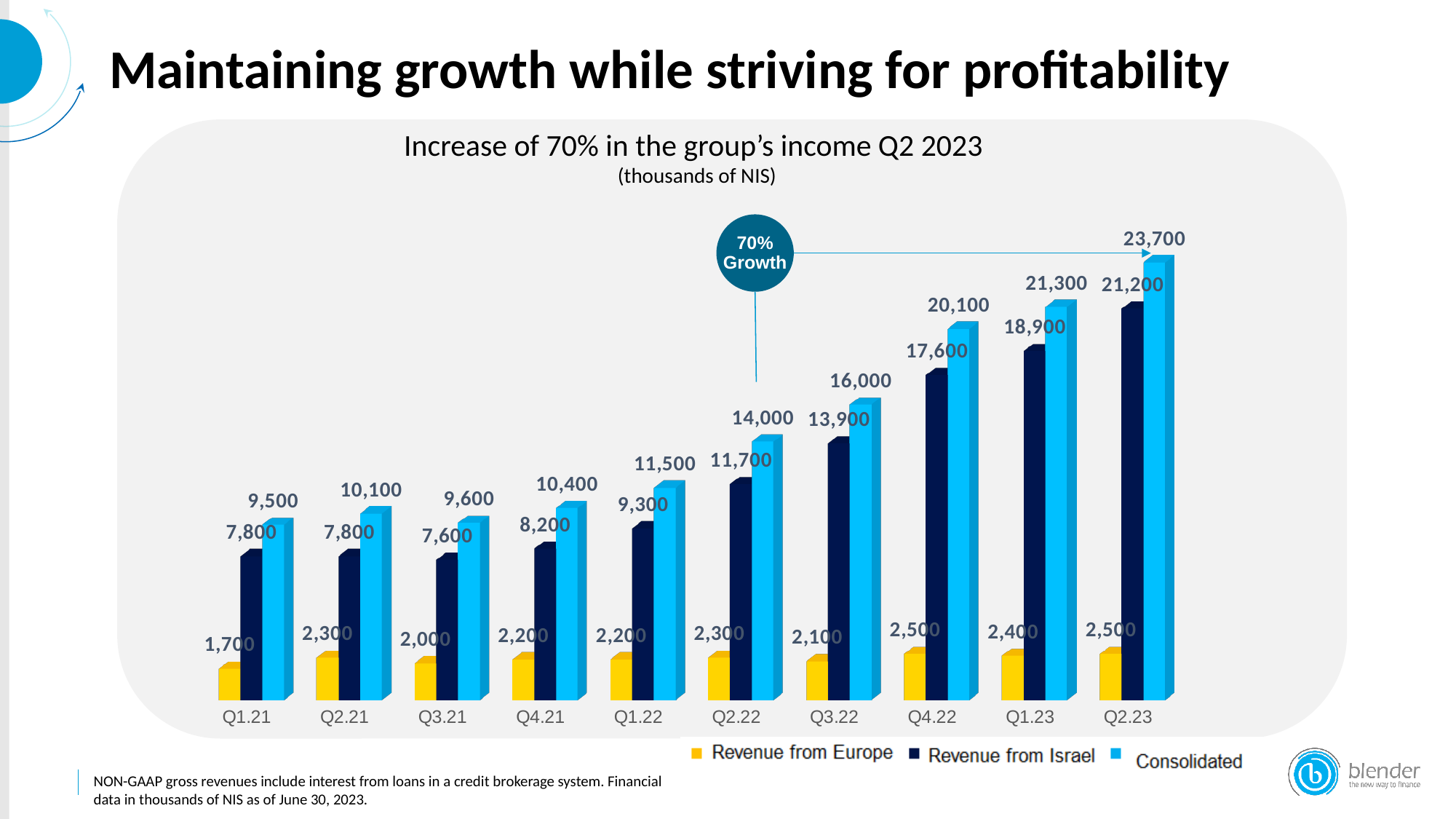
What is the difference between the Consolidated values for Q2.23 and Q2.22? 9,700 Which quarter has the lowest Revenue from Israel value? Q3.21 How many series does the legend list? 3 What kind of chart is shown on the slide? Bar chart Does the Consolidated series generally rise or fall from Q1.21 to Q2.23? Rise Which quarter has the highest Consolidated value? Q2.23 What growth percentage is shown in the circle callout on the chart? 70% Growth What is the Revenue from Europe value for Q1.21? 1,700 How many quarters are shown on the x axis? 10 What is the Consolidated value for Q2.23? 23,700 What is the Revenue from Israel value for Q4.22? 17,600 Which is larger, Revenue from Israel in Q1.23 or Revenue from Israel in Q4.22? Q1.23